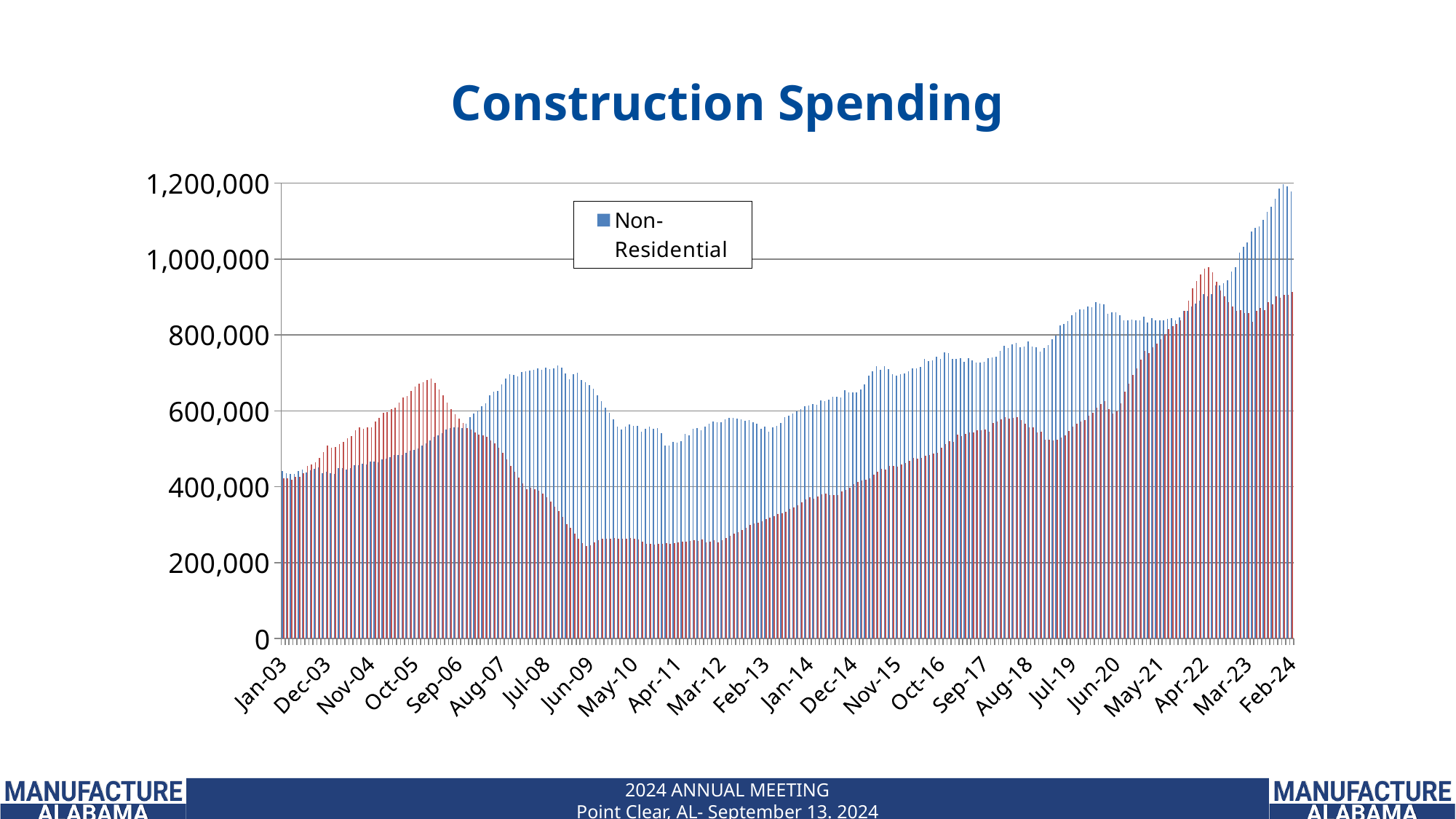
Is the Non-Residential value for Feb-24 greater or less than 1,000,000? greater What series name does the legend list? Non-Residential Which is larger, the Non-Residential value for Feb-24 or for Jan-03? Feb-24 Is the Non-Residential value for Jun-20 greater or less than 800,000? greater Is the Non-Residential value for Jul-08 greater or less than 600,000? greater Does the Non-Residential series rise or fall between Jul-08 and May-10? fall What kind of chart is shown on the slide? bar chart What is the title of the chart? Construction Spending Does the Non-Residential series rise or fall between Mar-23 and Feb-24? rise